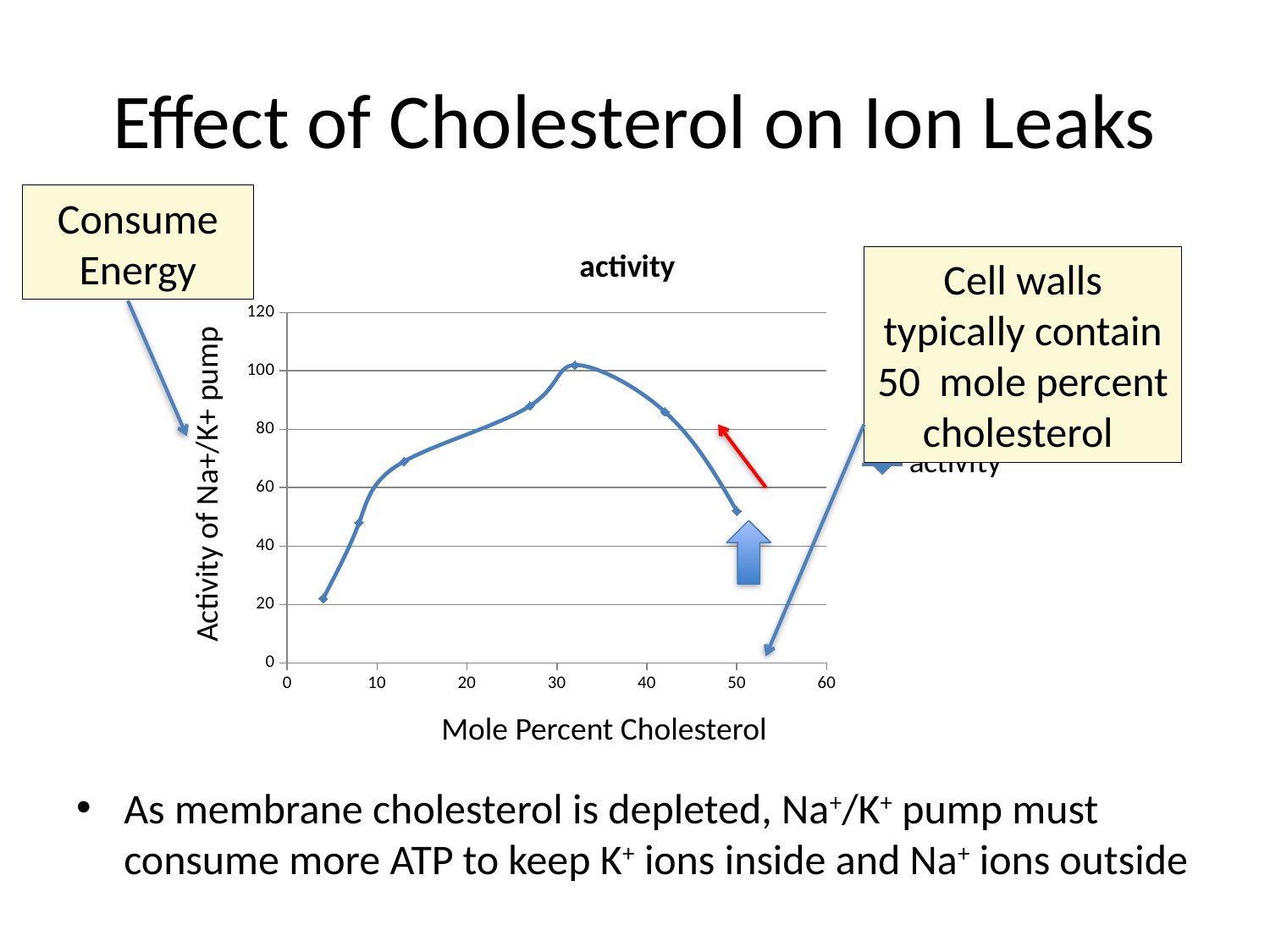
Does the activity rise or fall as mole percent cholesterol increases from 0 to 30? rise What is the title of the chart? activity What is the x-axis title of the chart? Mole Percent Cholesterol How many data points are plotted on the line? 7 What kind of chart is shown on the slide? line chart Is the activity value at the last plotted point (near 50 mole percent cholesterol) greater or less than 40? greater Which is larger: the activity at the first plotted point (near 4 mole percent) or at the last plotted point (near 50 mole percent)? the last plotted point (near 50 mole percent) How many series does the chart plot? 1 Is the activity value at the first plotted point (near 4 mole percent cholesterol) greater or less than 40? less Is the activity value at the last plotted point (near 50 mole percent cholesterol) greater or less than 60? less Does the activity rise or fall as mole percent cholesterol increases from 32 to 50? fall